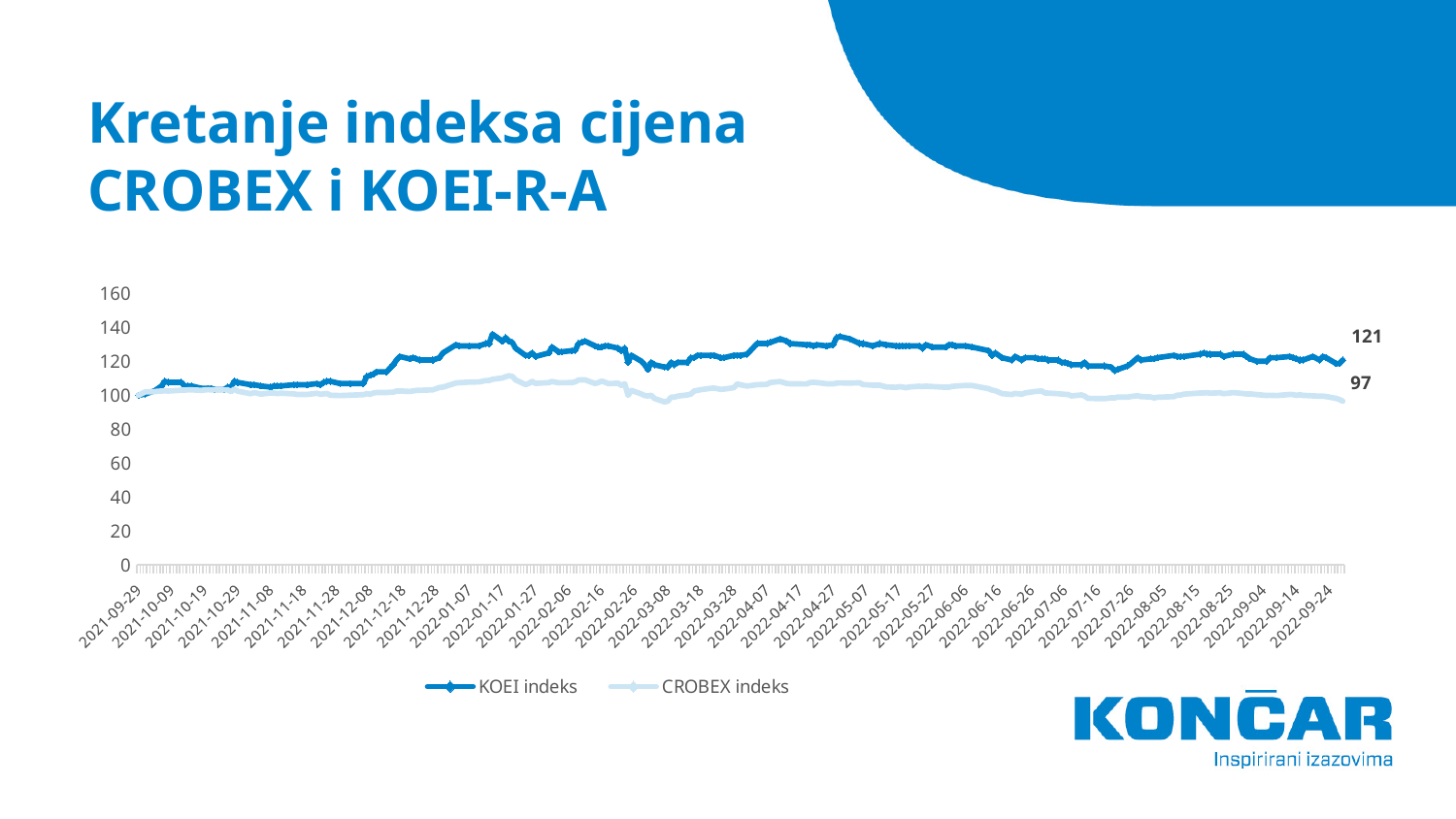
Is the final value of the CROBEX indeks series greater or less than 100? less What type of chart is shown on the slide? line chart Which series has the higher final labelled value, KOEI indeks or CROBEX indeks? KOEI indeks What is the final labelled value of the KOEI indeks series? 121 How many series does the legend list? 2 What is the title of the chart on the slide? Kretanje indeksa cijena CROBEX i KOEI-R-A What is the final labelled value of the CROBEX indeks series? 97 Is the final value of the KOEI indeks series greater or less than 120? greater Is the KOEI indeks value around 2022-01-17 greater or less than 120? greater Which series stays higher than the other for most of the period shown? KOEI indeks What is the difference between the final labelled values of KOEI indeks and CROBEX indeks? 24 What is the highest value shown on the vertical axis? 160